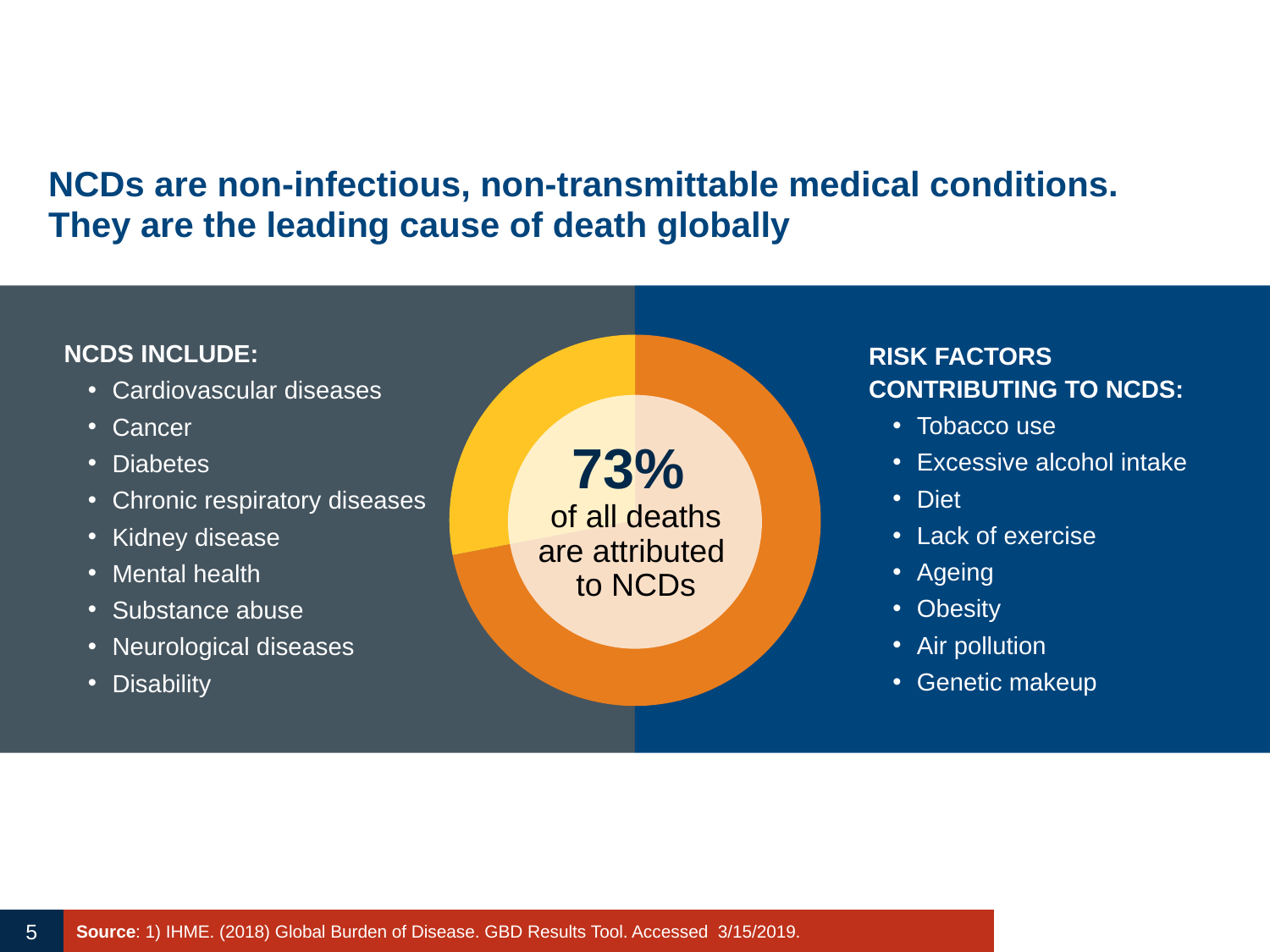
What kind of chart is shown in the centre of the slide? pie chart (donut) Is the share of deaths not attributed to NCDs (the yellow slice) greater or less than 50%? less How many slices does the chart have? 2 Is the share of deaths attributed to NCDs greater or less than 50%? greater What text is printed in the centre of the chart? 73% of all deaths are attributed to NCDs According to the chart, what percentage of all deaths are attributed to NCDs? 73% What colour is the slice representing deaths attributed to NCDs? orange Which slice of the chart is larger, the orange one or the yellow one? orange